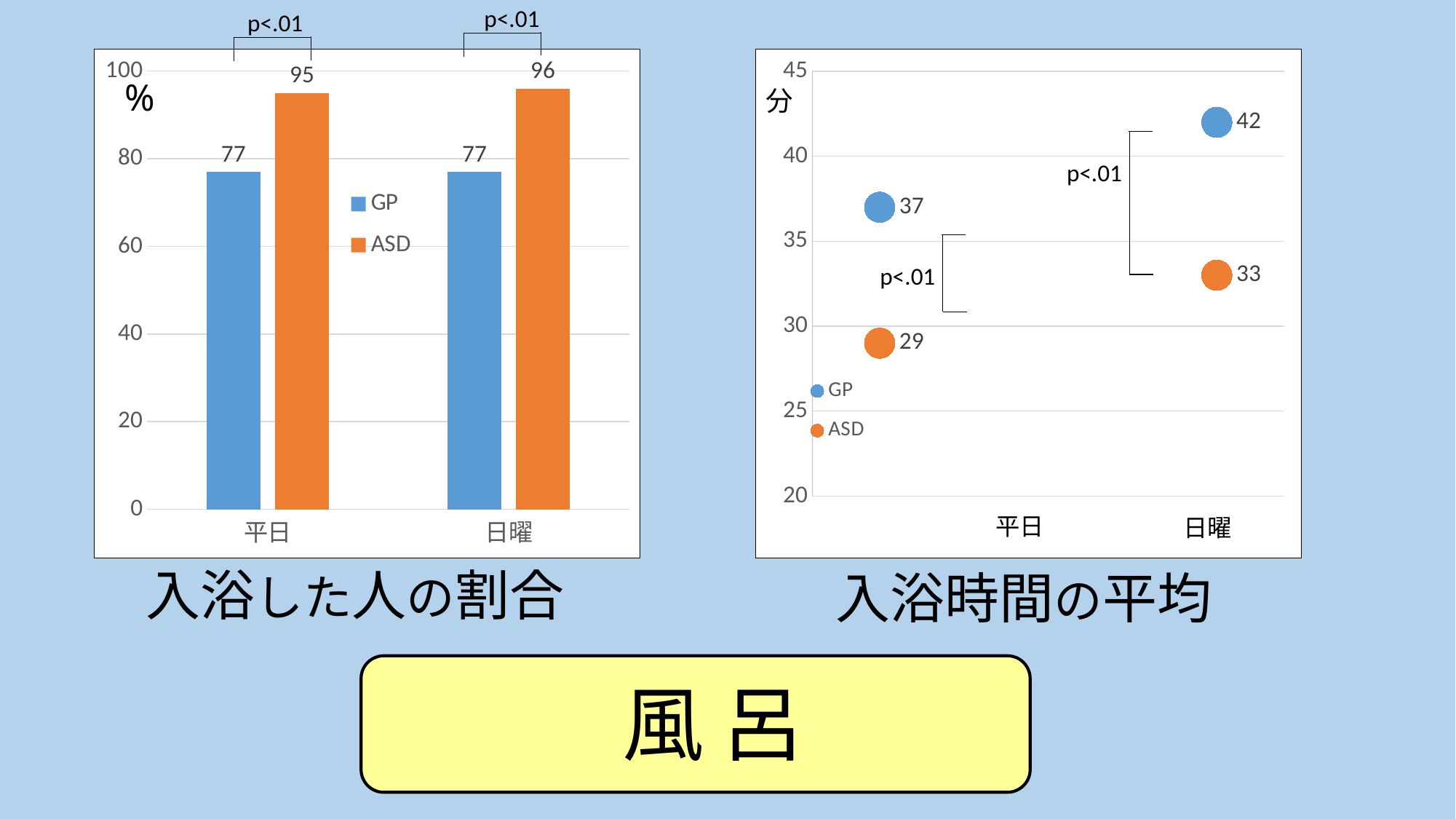
In the left chart (入浴した人の割合), what is the value for ASD on 平日? 95 In the right chart (入浴時間の平均), what is the value for GP on 日曜? 42 In the left chart (入浴した人の割合), which series has the higher value on 平日, GP or ASD? ASD In the right chart (入浴時間の平均), what unit is shown on the vertical axis? 分 In the right chart (入浴時間の平均), which point has the lowest value? ASD on 平日 In the left chart (入浴した人の割合), what is the difference between the ASD and GP values on 日曜? 19 In the right chart (入浴時間の平均), what is the difference between the GP and ASD values on 平日? 8 What kind of chart is the left chart (入浴した人の割合)? Bar chart In the right chart (入浴時間の平均), what is the value for ASD on 平日? 29 In the left chart (入浴した人の割合), what is the value for GP on 日曜? 77 In the right chart (入浴時間の平均), do the GP values rise or fall from 平日 to 日曜? Rise In the left chart (入浴した人の割合), how many series does the legend list? 2